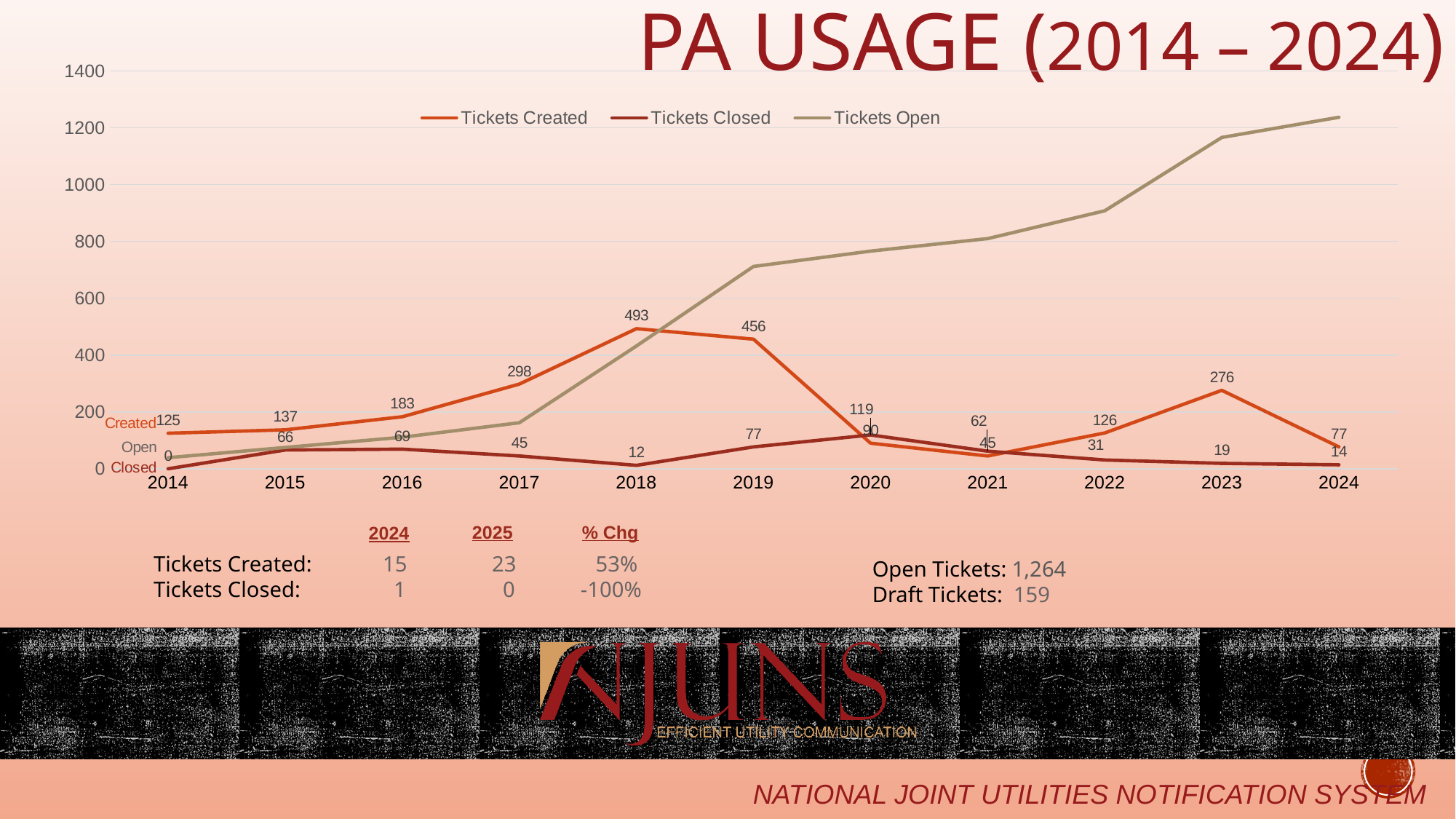
What is the value of Tickets Closed in 2019? 77 What is the value of Tickets Created in 2018? 493 In which year is Tickets Created highest? 2018 What kind of chart is shown on the slide? line chart How many series does the chart legend list? 3 What is the difference between Tickets Created in 2018 and in 2019? 37 In which year is Tickets Closed lowest? 2014 In 2023, which is larger: Tickets Created or Tickets Closed? Tickets Created What is the title of the chart on the slide? PA USAGE (2014 – 2024) How many years are plotted along the x axis of the chart? 11 Is the value for Tickets Open in 2024 greater or less than 1000? greater Does the Tickets Open line rise or fall from 2014 to 2024? rise